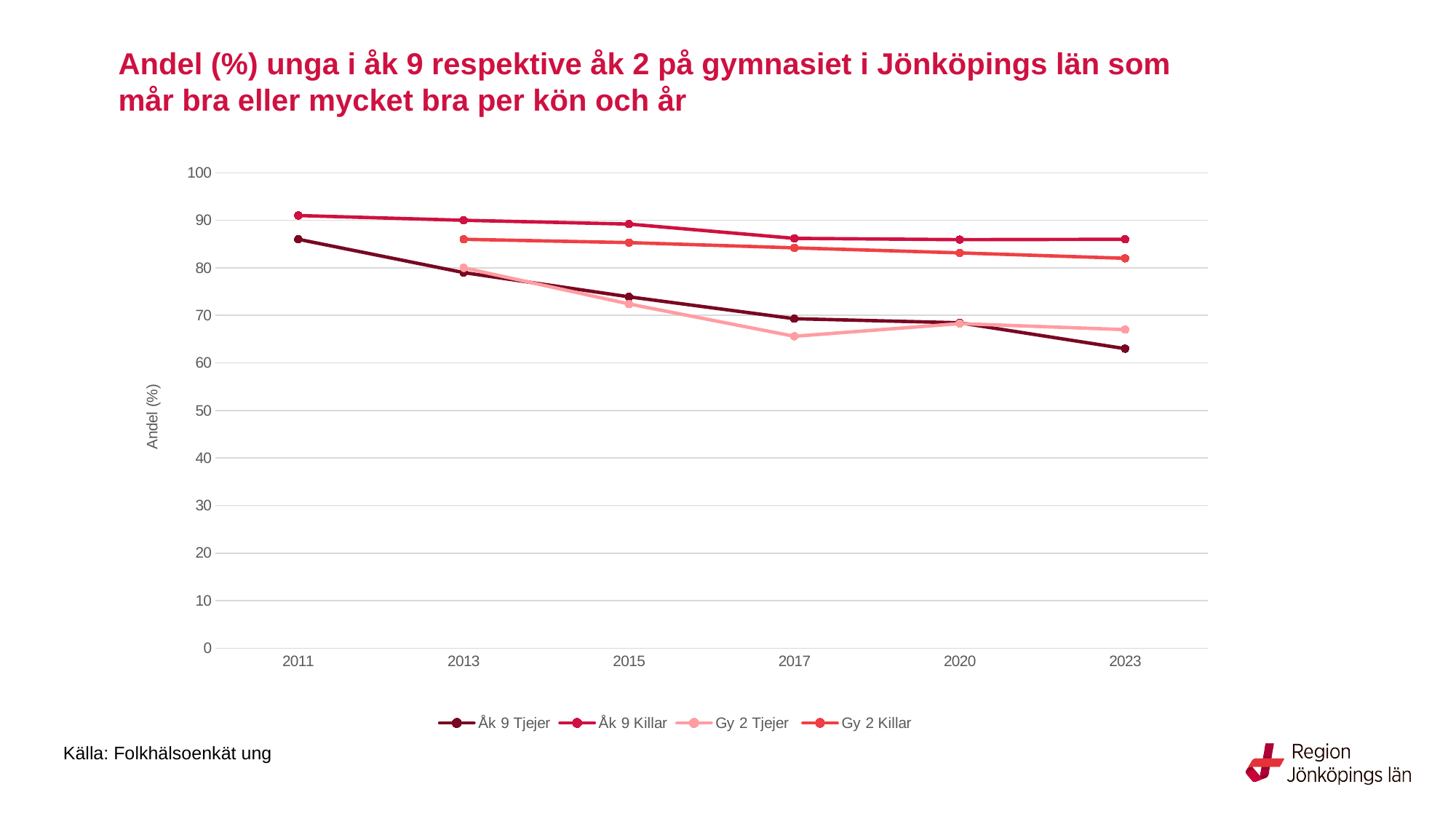
How many years are shown on the x axis? 6 Is the value for Åk 9 Killar in 2023 greater or less than 80? greater How many data points does the Gy 2 Tjejer series have? 5 Does the Åk 9 Tjejer series rise or fall from 2011 to 2023? fall How many series does the legend list? 4 Is the value for Gy 2 Tjejer in 2017 greater or less than 70? less Is the value for Åk 9 Tjejer in 2023 greater or less than 70? less What kind of chart is shown on the slide? line chart What is the label on the y axis? Andel (%) Which series has the lowest value in 2023? Åk 9 Tjejer Which series has the highest value in 2023? Åk 9 Killar In 2017, which is larger: the value for Åk 9 Tjejer or for Gy 2 Tjejer? Åk 9 Tjejer